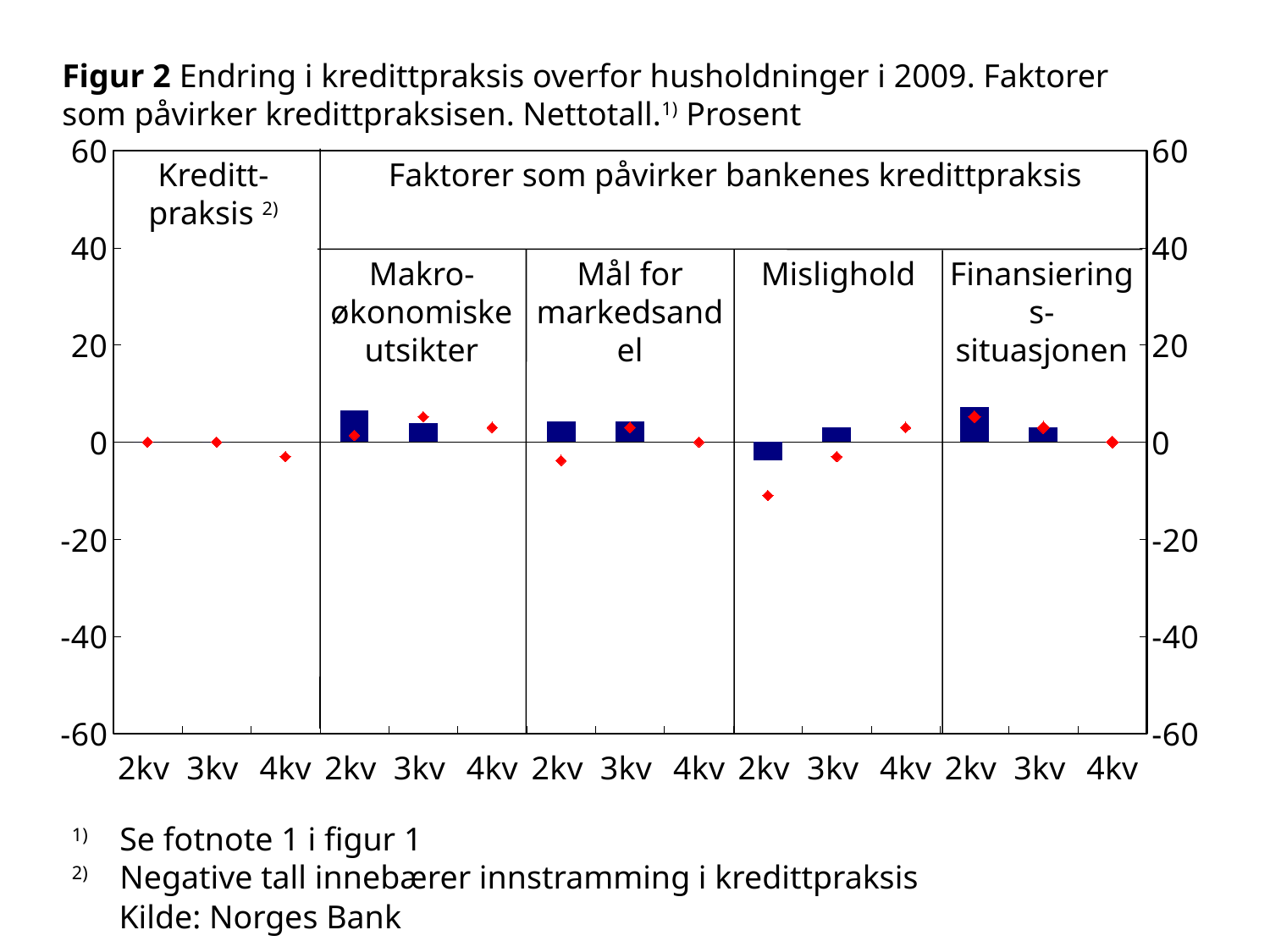
How many factor panels are listed under "Faktorer som påvirker bankenes kredittpraksis"? 4 In which panel and quarter is the lowest red marker found? Mislighold, 2kv Is the bar for 2kv in the Makroøkonomiske utsikter panel greater or less than 0? greater How many quarter categories are shown along the x axis in total? 15 What kind of chart is shown on the slide? combination chart of bars and red diamond markers Is the bar for 2kv in the Finansieringssituasjonen panel greater or less than 20? less Is the bar for 2kv in the Mislighold panel greater or less than 0? less In which panel and quarter is the lowest bar found? Mislighold, 2kv What is the maximum value shown on the y axis? 60 Which is larger: the bar for 2kv in the Makroøkonomiske utsikter panel or the bar for 2kv in the Mislighold panel? Makroøkonomiske utsikter 2kv What is the heading of the leftmost panel of the chart? Kredittpraksis